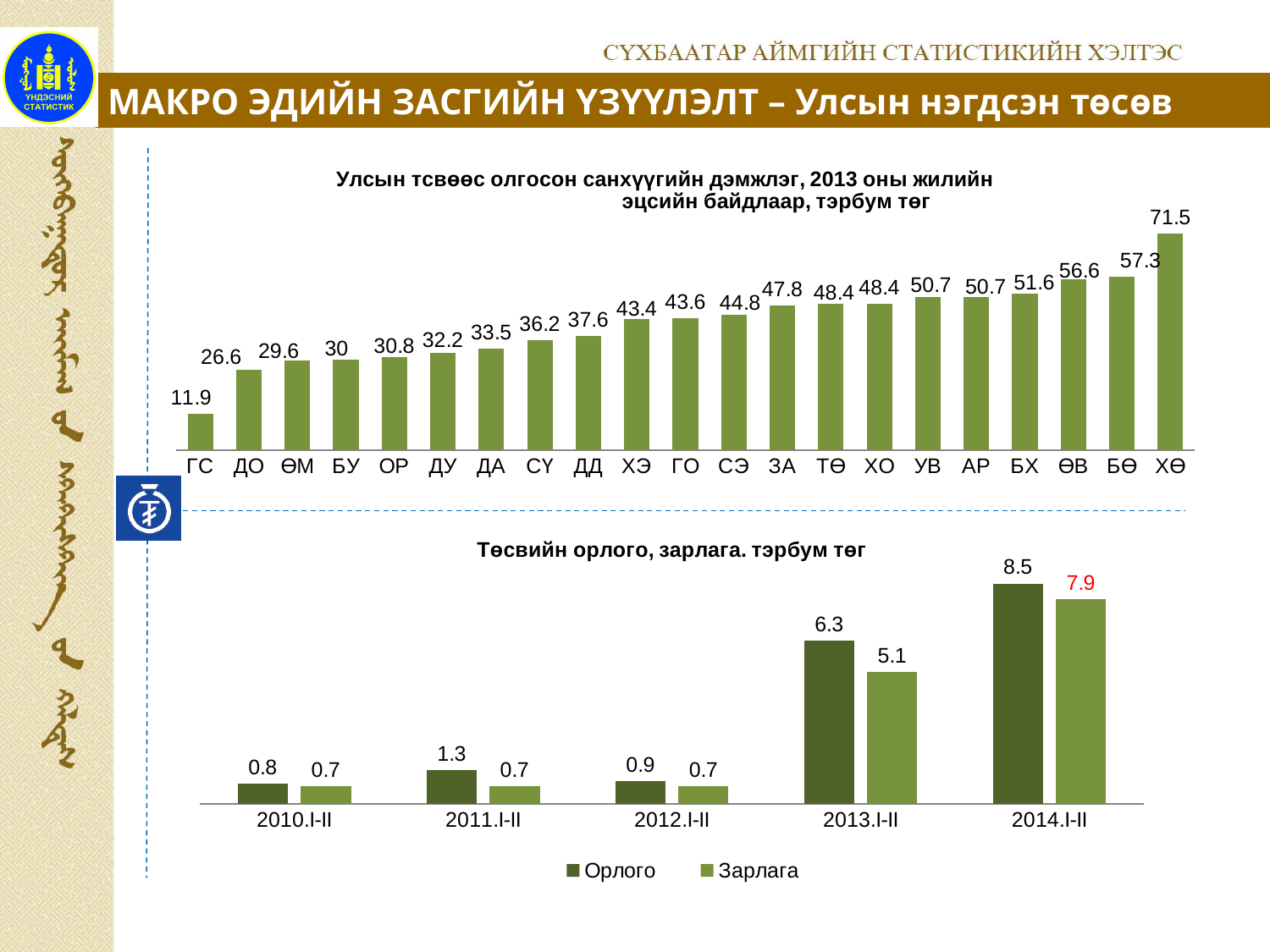
In the top chart (Улсын тсвөөс олгосон санхүүгийн дэмжлэг), which category has the highest value? ХӨ In the top chart (Улсын тсвөөс олгосон санхүүгийн дэмжлэг), do the values rise or fall from left to right? rise In the top chart (Улсын тсвөөс олгосон санхүүгийн дэмжлэг), what is the value for ГС? 11.9 In the top chart (Улсын тсвөөс олгосон санхүүгийн дэмжлэг), what is the value for ХӨ? 71.5 In the top chart (Улсын тсвөөс олгосон санхүүгийн дэмжлэг), how many categories are shown? 21 In the top chart (Улсын тсвөөс олгосон санхүүгийн дэмжлэг), which category has the lowest value? ГС What kind of chart is the bottom chart (Төсвийн орлого, зарлага)? bar chart In the bottom chart (Төсвийн орлого, зарлага), how many series does the legend list? 2 In the bottom chart (Төсвийн орлого, зарлага), which is larger for 2011.I-II, Орлого or Зарлага? Орлого In the bottom chart (Төсвийн орлого, зарлага), what is the Орлого value for 2014.I-II? 8.5 In the bottom chart (Төсвийн орлого, зарлага), what is the Зарлага value for 2013.I-II? 5.1 In the top chart (Улсын тсвөөс олгосон санхүүгийн дэмжлэг), what is the difference between the values for ХӨ and БӨ? 14.2